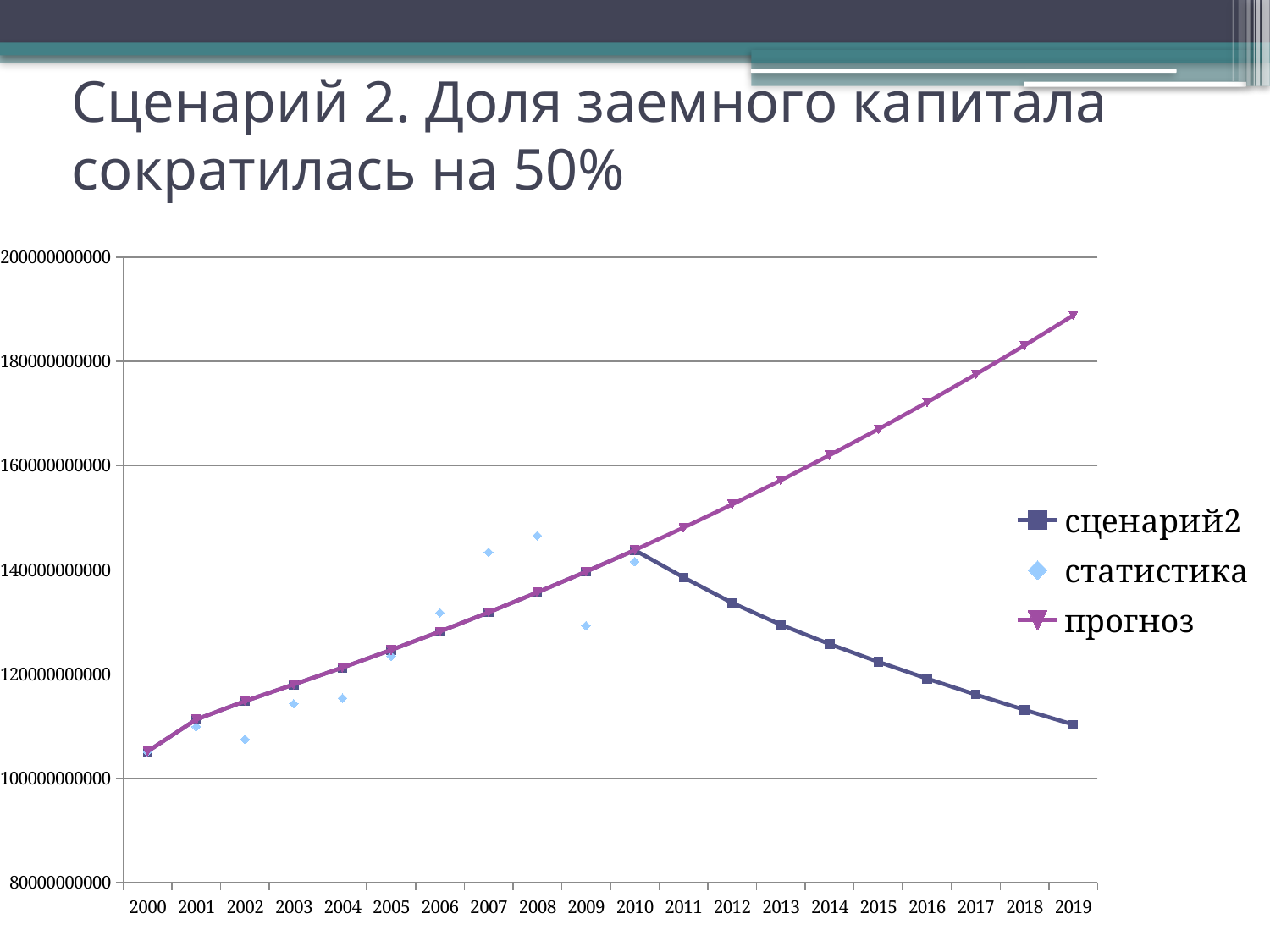
Is the value of прогноз in 2019 greater or less than 180000000000? greater In which year does the прогноз series reach its highest value? 2019 Is the value of статистика in 2002 greater or less than 120000000000? less In 2019, which series has the higher value, прогноз or сценарий2? прогноз How many series does the legend list? 3 Is the value of сценарий2 in 2019 greater or less than 120000000000? less Which series are listed in the legend? сценарий2, статистика, прогноз How many years are shown on the x axis? 20 Does the сценарий2 series rise or fall from 2010 to 2019? fall What kind of chart is shown on the slide? line chart Does the прогноз series rise or fall from 2000 to 2019? rise